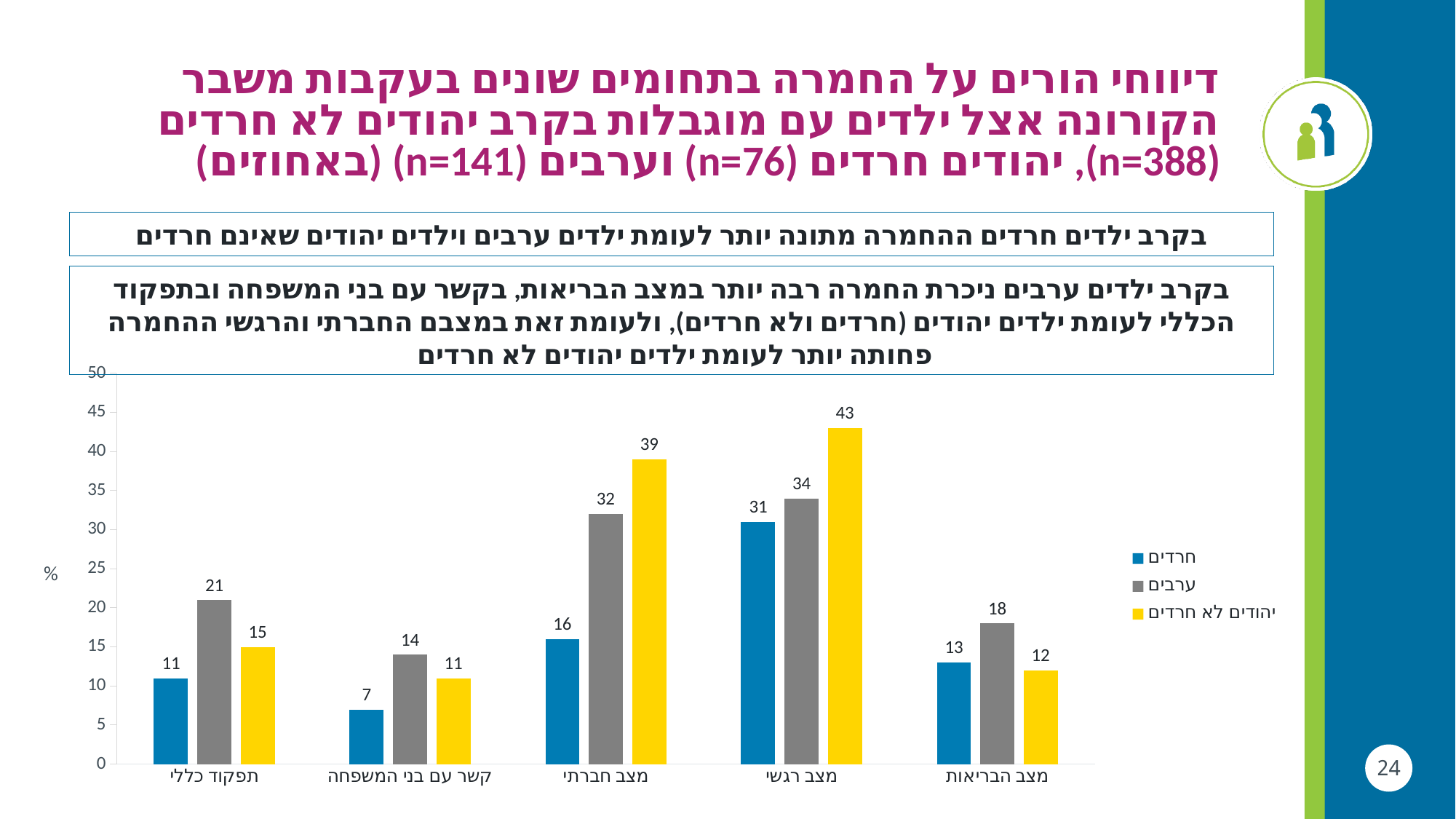
In the מצב הבריאות category, which is larger: the value for ערבים or the value for יהודים לא חרדים? ערבים How many categories are shown on the x axis of the chart? 5 What kind of chart is shown on the slide? bar chart Which series is shown in yellow in the legend? יהודים לא חרדים Which category has the lowest value for the חרדים series? קשר עם בני המשפחה What is the value for יהודים לא חרדים in the מצב רגשי category? 43 Which category has the highest value for the יהודים לא חרדים series? מצב רגשי What is the difference between the ערבים and חרדים values in the תפקוד כללי category? 10 How many series does the legend list? 3 Is the value for ערבים in the מצב רגשי category greater or less than 30? greater What is the value for חרדים in the קשר עם בני המשפחה category? 7 What is the value for ערבים in the מצב חברתי category? 32